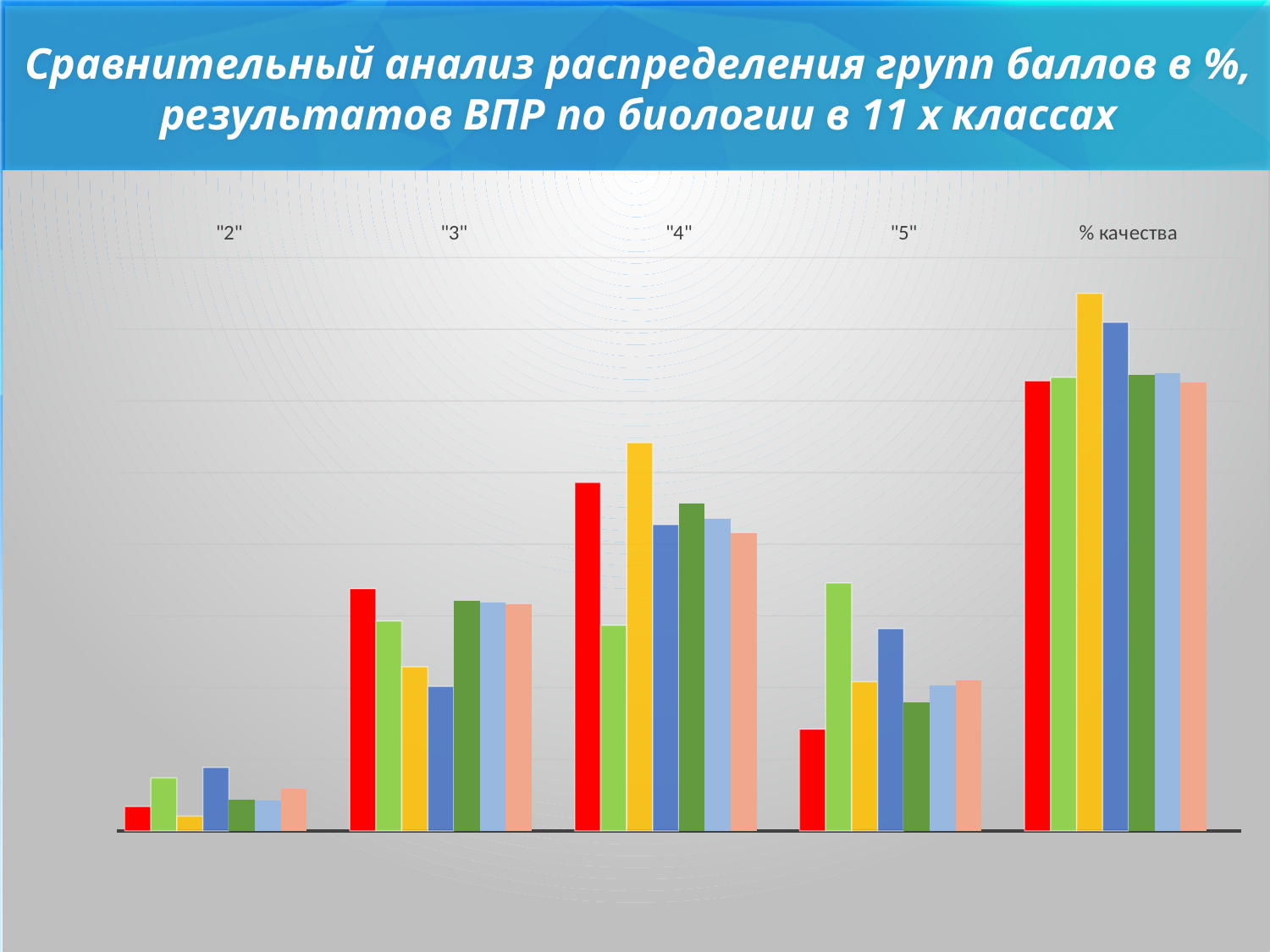
In the "4" category, which is taller: the red bar or the light green bar? red Which category on the x axis has the tallest bars overall? % качества In the "% качества" category, which coloured bar is the tallest? yellow In the "3" category, which coloured bar is the tallest? red In the "2" category, which coloured bar is the shortest? yellow Which category on the x axis has the shortest bars overall? "2" What kind of chart is shown on the slide? bar chart How many bars are plotted in each category group of the chart? 7 How many categories are shown along the x axis of the chart? 5 What is the last category label on the x axis of the chart? % качества